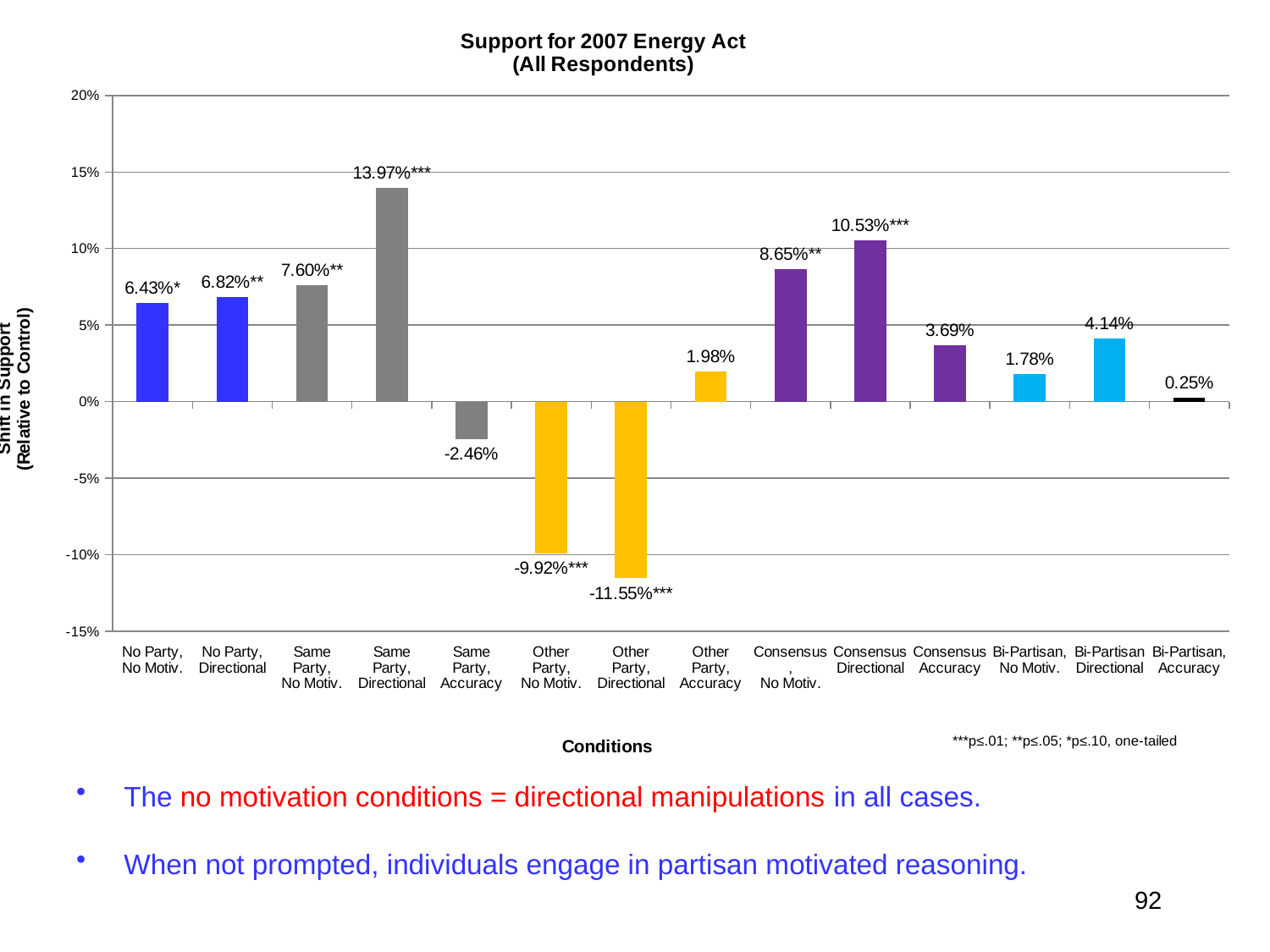
Which is larger: the value for Consensus, Directional or the value for Consensus, No Motiv.? Consensus, Directional What is the difference between the Bi-Partisan, Directional value (4.14%) and the Bi-Partisan, No Motiv. value (1.78%)? 2.36 percentage points What is the shift in support for the Consensus, Accuracy condition? 3.69% What is the shift in support for the Other Party, Accuracy condition? 1.98% What is the shift in support for the Bi-Partisan, Accuracy condition? 0.25% What is the title of the chart? Support for 2007 Energy Act (All Respondents) What is the shift in support for the Same Party, Directional condition? 13.97%*** Which condition has the lowest shift in support? Other Party, Directional Which condition has the highest shift in support? Same Party, Directional How many conditions (categories) are plotted on the x axis? 14 What is the difference between the Same Party, Directional value (13.97%) and the Same Party, No Motiv. value (7.60%)? 6.37 percentage points What type of chart is shown on the slide? Bar chart